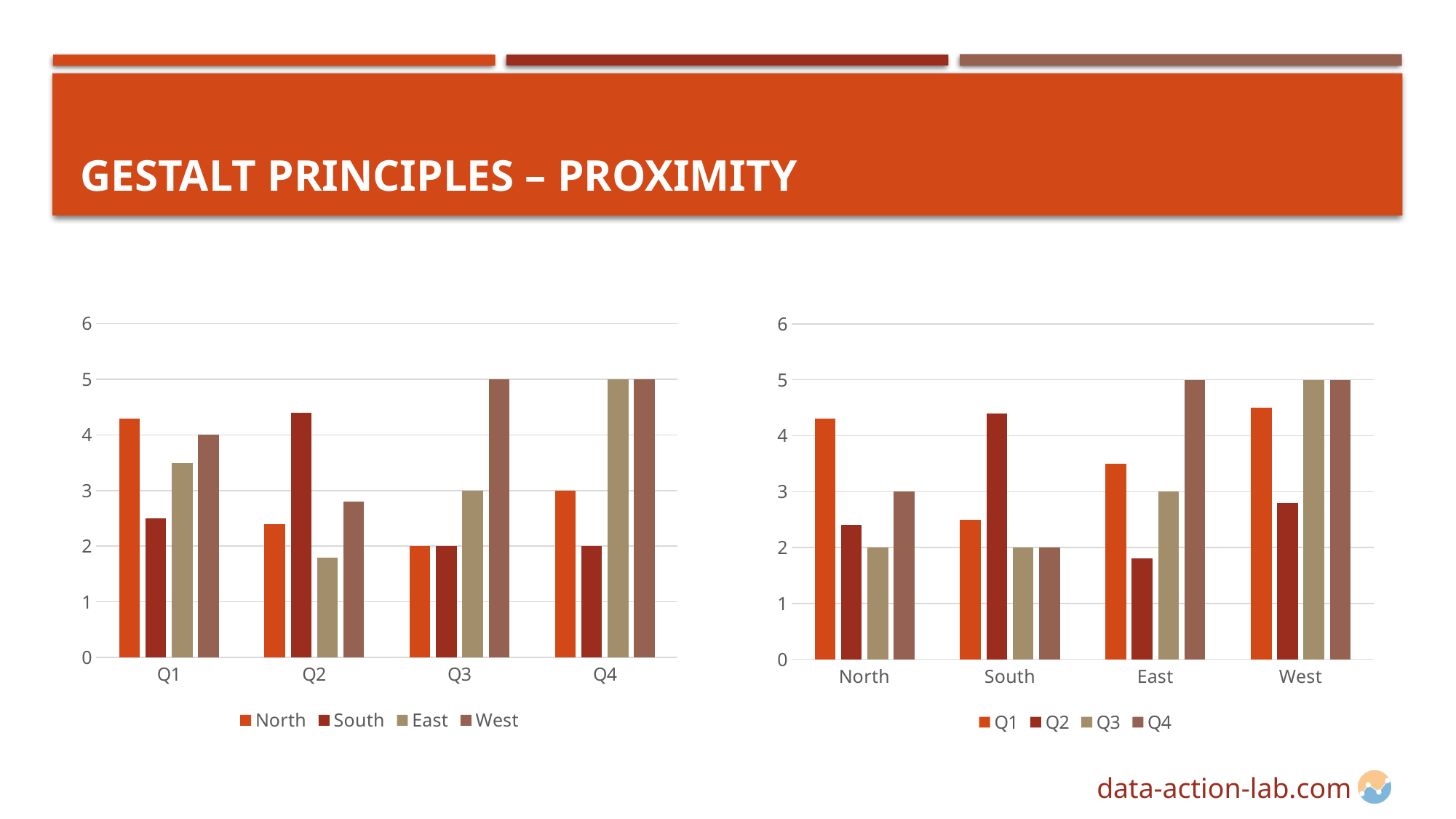
How many categories are shown on the x axis of the right chart? 4 In the left chart, is the value for East in Q2 greater or less than 2? less In the left chart, what is the value for West in Q3? 5 In the right chart, what is the value for Q4 in the North category? 3 In the right chart, which is larger in the West category: Q1 or Q2? Q1 In the left chart, is the value for North in Q1 greater or less than 4? greater In the left chart, which series has the highest value in Q2? South In the right chart, what is the value for Q3 in the East category? 3 What kind of chart is the chart on the left of the slide? bar chart In the left chart, what is the value for East in Q3? 3 How many series does the legend of the left chart list? 4 In the right chart, which series has the lowest value in the East category? Q2